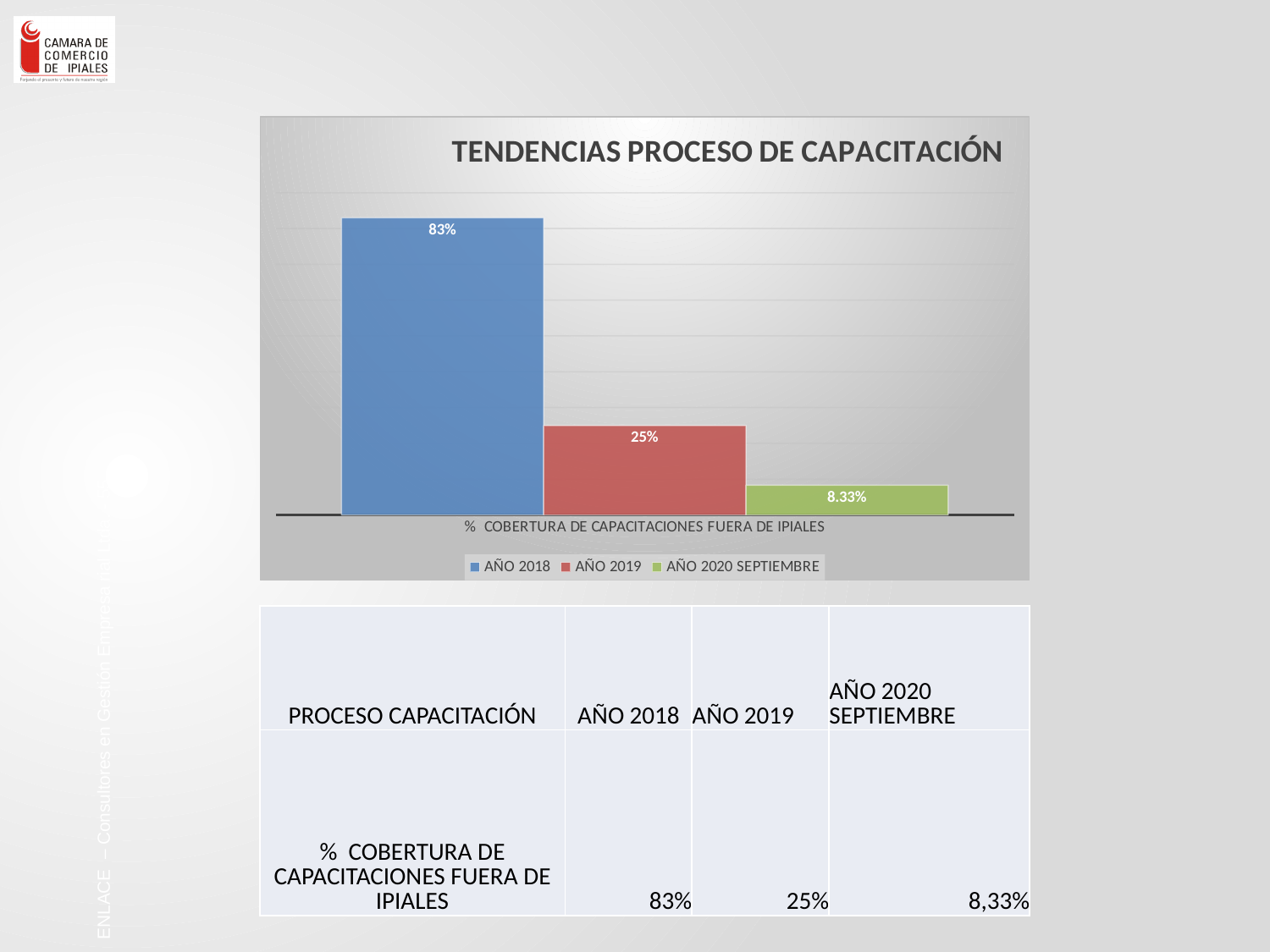
What is the category label shown on the x axis of the chart? % COBERTURA DE CAPACITACIONES FUERA DE IPIALES Which series has the lowest value in the chart? AÑO 2020 SEPTIEMBRE What is the value for AÑO 2019 in the chart? 25% Which is larger, the value for AÑO 2019 or the value for AÑO 2020 SEPTIEMBRE? AÑO 2019 How many series does the legend list? 3 What is the value for AÑO 2020 SEPTIEMBRE in the chart? 8.33% Do the values rise or fall from AÑO 2018 to AÑO 2020 SEPTIEMBRE? Fall What kind of chart is shown on the slide? Bar chart Which series has the highest value in the chart? AÑO 2018 What is the difference between the AÑO 2018 value and the AÑO 2019 value? 58% What is the value for AÑO 2018 in the chart? 83% What is the title of the chart? TENDENCIAS PROCESO DE CAPACITACIÓN